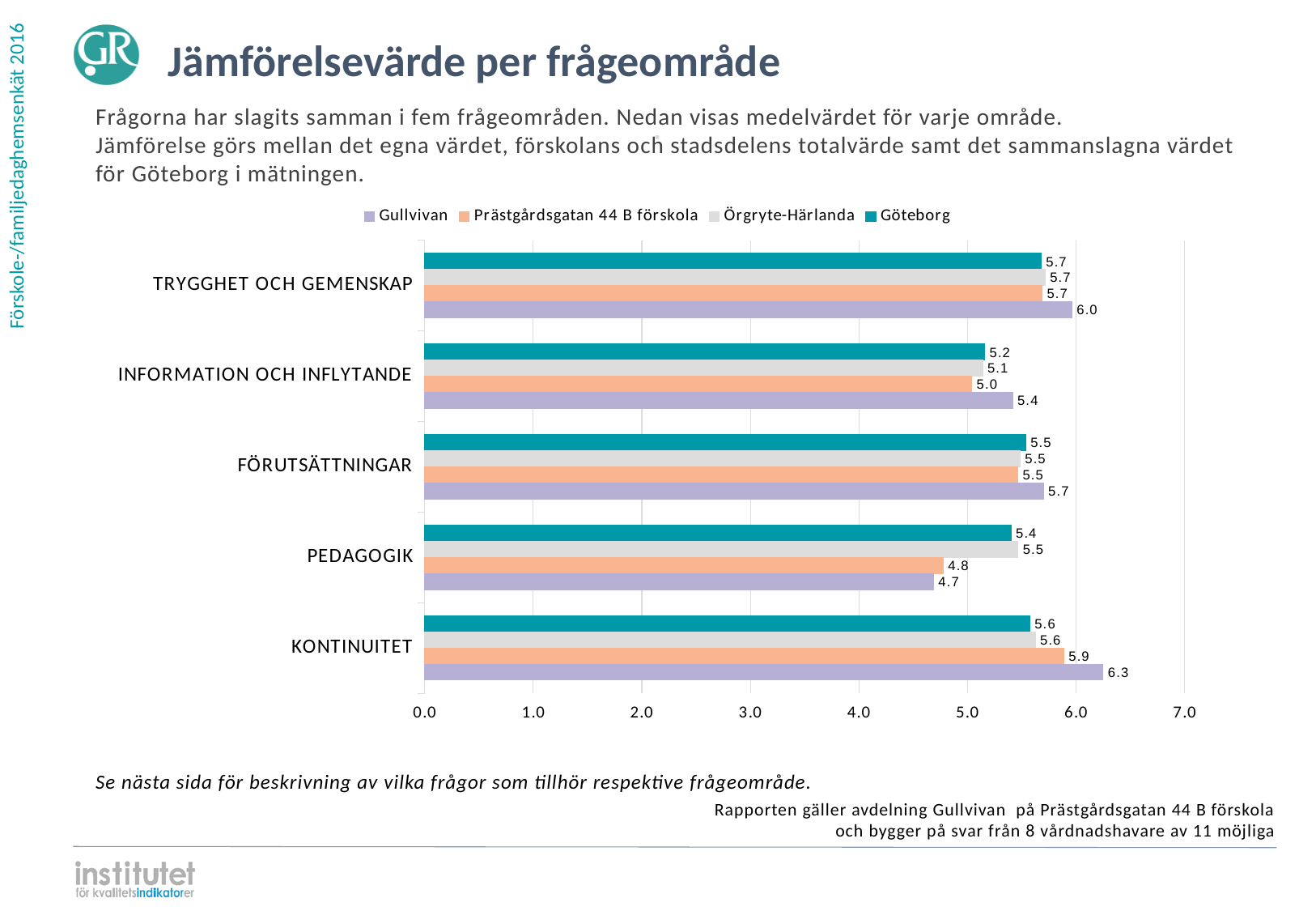
How many series does the legend list? 4 What is the value for Gullvivan in the KONTINUITET category? 6.3 How many question areas (categories) are shown on the chart? 5 In which category does Gullvivan have its lowest value? PEDAGOGIK What is the value for Göteborg in the INFORMATION OCH INFLYTANDE category? 5.2 What is the value for Prästgårdsgatan 44 B förskola in the PEDAGOGIK category? 4.8 What is the value for Örgryte-Härlanda in the TRYGGHET OCH GEMENSKAP category? 5.7 What is the title of the slide containing the chart? Jämförelsevärde per frågeområde In the PEDAGOGIK category, which is larger: the value for Örgryte-Härlanda or the value for Gullvivan? Örgryte-Härlanda What is the difference between the Gullvivan value and the Göteborg value in the KONTINUITET category? 0.7 In which category does Gullvivan have its highest value? KONTINUITET What kind of chart is shown on the slide? Bar chart